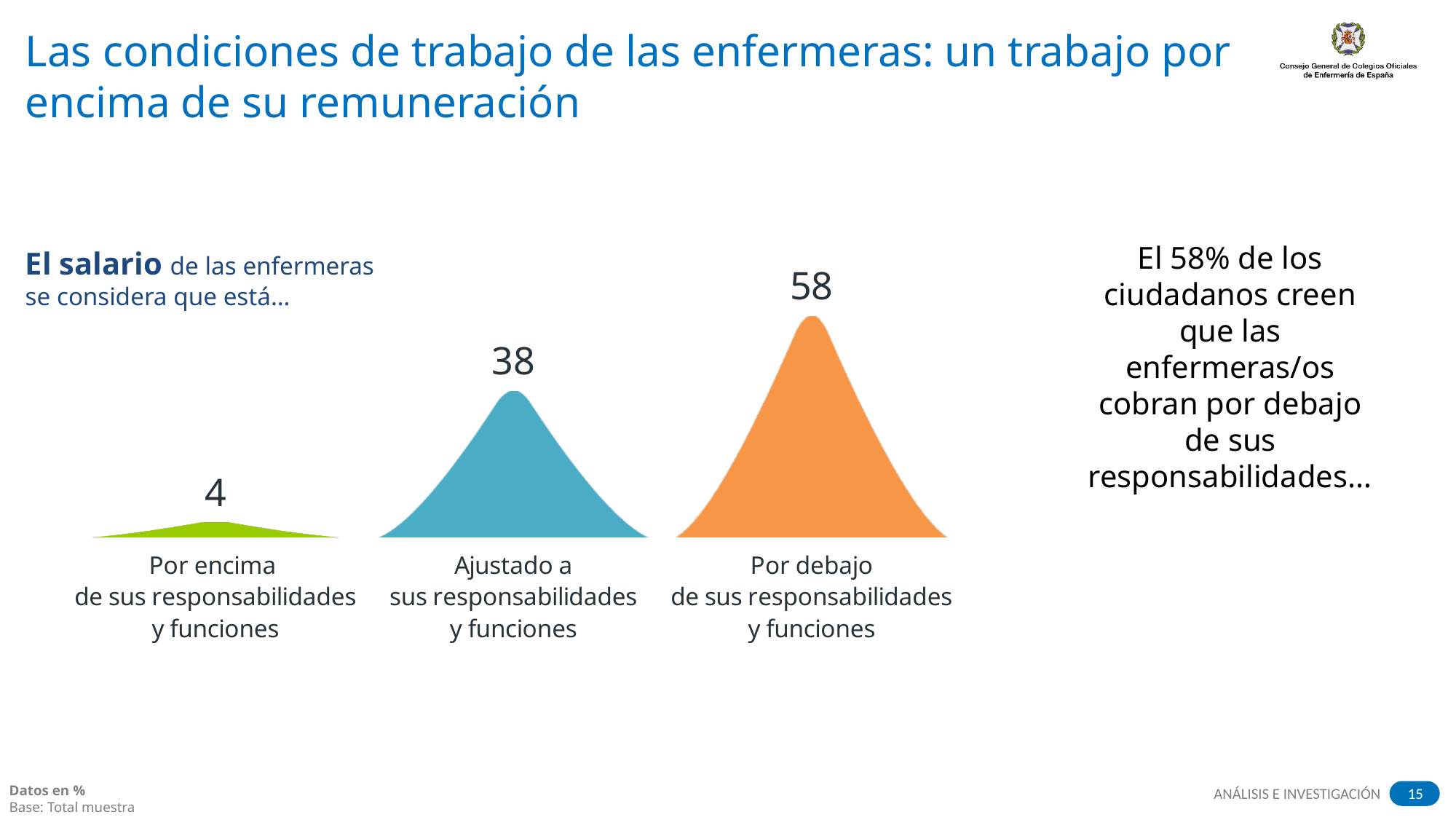
Which category has the highest value? Por debajo de sus responsabilidades y funciones What value is shown for 'Por encima de sus responsabilidades y funciones'? 4 How many categories are shown in the chart? 3 Which is larger: the value for 'Ajustado a sus responsabilidades y funciones' or for 'Por encima de sus responsabilidades y funciones'? Ajustado a sus responsabilidades y funciones Which category has the lowest value? Por encima de sus responsabilidades y funciones What is the difference between the values for 'Ajustado a' and 'Por encima de' sus responsabilidades y funciones? 34 What value is shown for 'Por debajo de sus responsabilidades y funciones'? 58 What is the total of the three values shown in the chart? 100 Do the values rise or fall from left to right across the categories? rise What is the difference between the values for 'Por debajo' and 'Ajustado a' sus responsabilidades y funciones? 20 What colour is the shape for 'Por debajo de sus responsabilidades y funciones'? orange What value is shown for 'Ajustado a sus responsabilidades y funciones'? 38